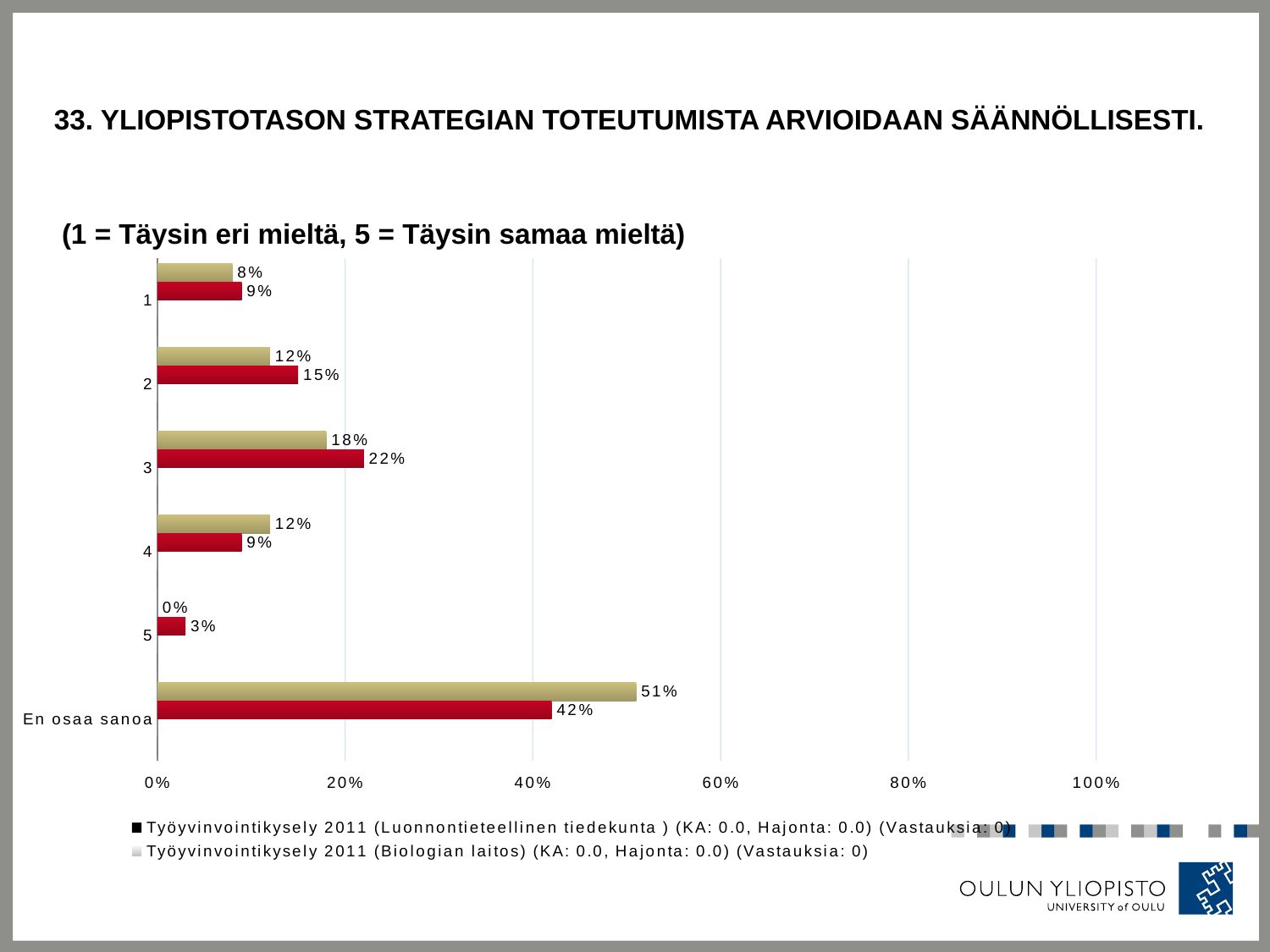
Which category has the highest value among the red bars? En osaa sanoa For category 4, which bar is larger, the red bar or the tan bar? The tan bar What is the difference between the tan bar and the red bar for "En osaa sanoa"? 9% Which category has the lowest value among the tan bars? 5 What is the value of the red bar for category 3? 22% What is the value of the red bar for category 5? 3% Is the value of the red bar for "En osaa sanoa" greater or less than 40%? greater What is the value of the tan bar for the category "En osaa sanoa"? 51% How many series does the legend list? 2 What kind of chart is shown on the slide? Bar chart What is the difference between the red bar and the tan bar for category 2? 3% How many categories are shown on the vertical axis of the chart? 6